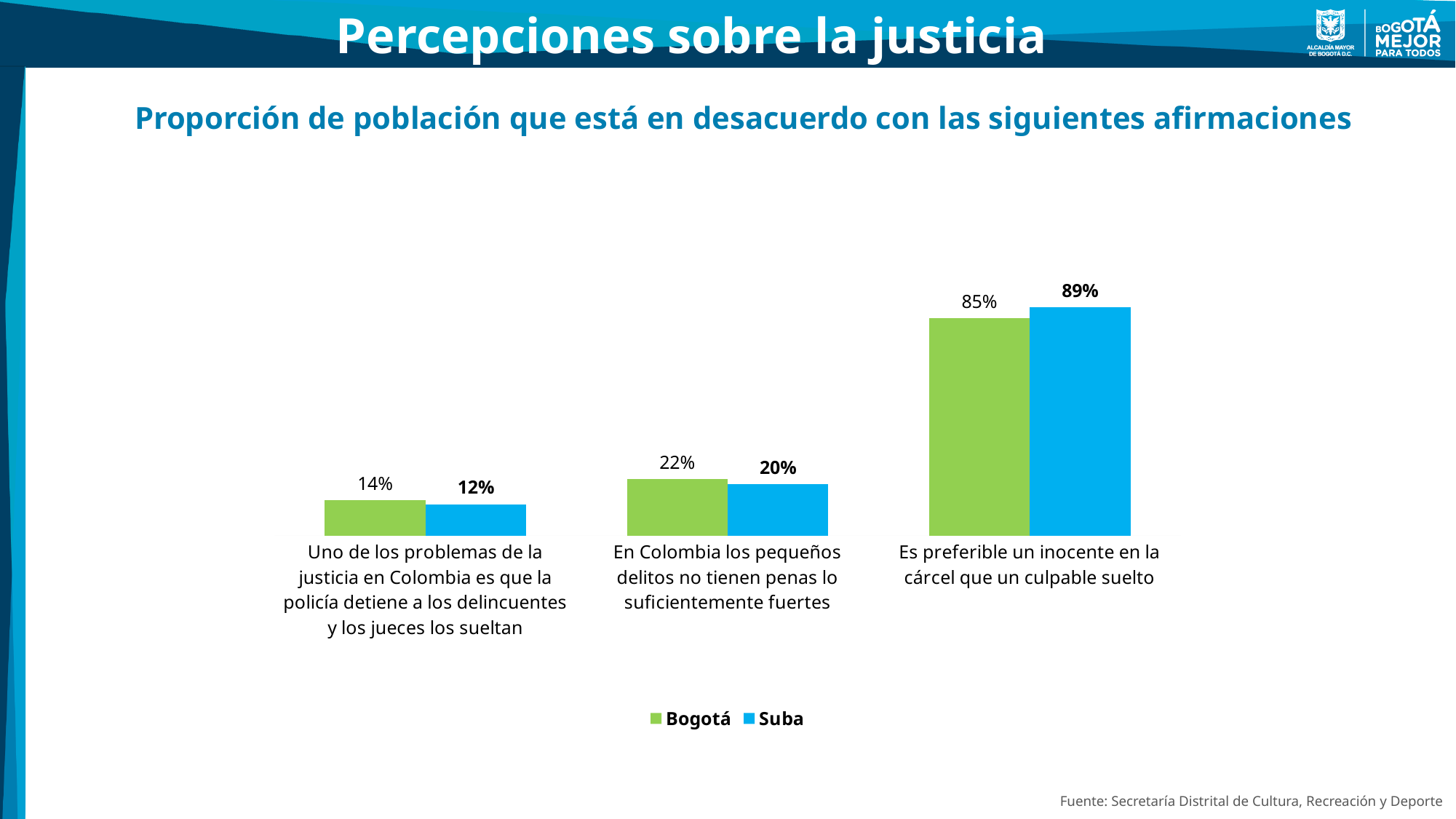
Which statement has the lowest Bogotá value? Uno de los problemas de la justicia en Colombia es que la policía detiene a los delincuentes y los jueces los sueltan Which statement has the highest Suba value? Es preferible un inocente en la cárcel que un culpable suelto What is the Bogotá value for "Es preferible un inocente en la cárcel que un culpable suelto"? 85% For "En Colombia los pequeños delitos no tienen penas lo suficientemente fuertes", which is larger, Bogotá or Suba? Bogotá Which series is shown in green in the legend? Bogotá How many series does the legend list? 2 What is the difference between the Suba and Bogotá values for "Es preferible un inocente en la cárcel que un culpable suelto"? 4% What is the difference between the Bogotá values for the first and second statements? 8% How many statements (categories) are shown in the chart? 3 What is the Suba value for the statement about the police detaining criminals and judges releasing them? 12% What kind of chart is shown on the slide? Bar chart What is the Suba value for "En Colombia los pequeños delitos no tienen penas lo suficientemente fuertes"? 20%